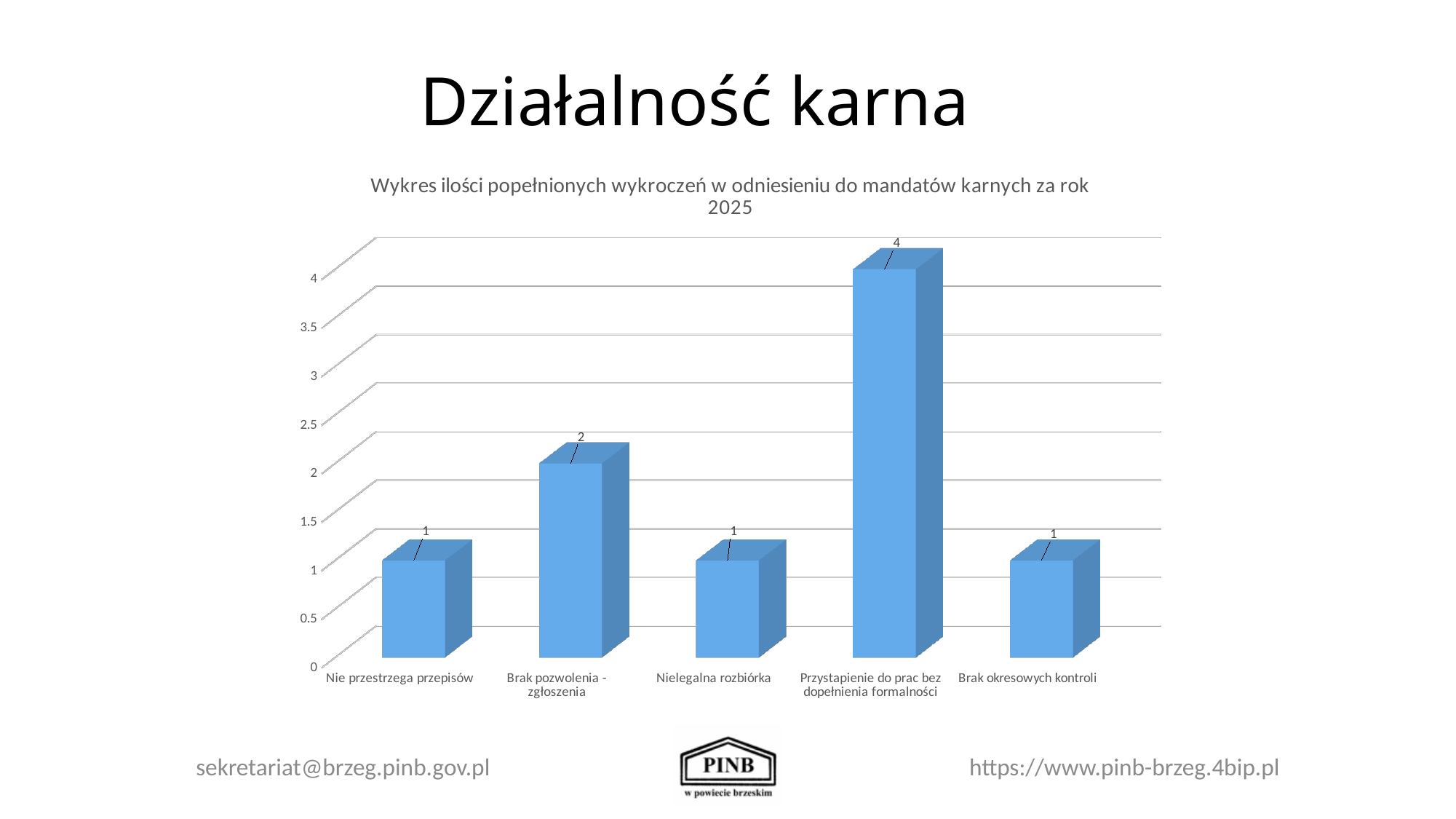
Which category has the highest value? Przystapienie do prac bez dopełnienia formalności Which is larger, the value for 'Brak pozwolenia - zgłoszenia' or the value for 'Nie przestrzega przepisów'? Brak pozwolenia - zgłoszenia Is the value for 'Przystapienie do prac bez dopełnienia formalności' greater or less than 3? greater What is the total of all the values shown in the chart? 9 What is the value for 'Brak pozwolenia - zgłoszenia'? 2 What is the difference between the values for 'Przystapienie do prac bez dopełnienia formalności' and 'Brak pozwolenia - zgłoszenia'? 2 What kind of chart is shown on the slide? bar chart What is the value for 'Brak okresowych kontroli'? 1 What is the title of the chart? Wykres ilości popełnionych wykroczeń w odniesieniu do mandatów karnych za rok 2025 What is the value for 'Przystapienie do prac bez dopełnienia formalności'? 4 How many categories are shown on the x axis? 5 What is the value for 'Nielegalna rozbiórka'? 1